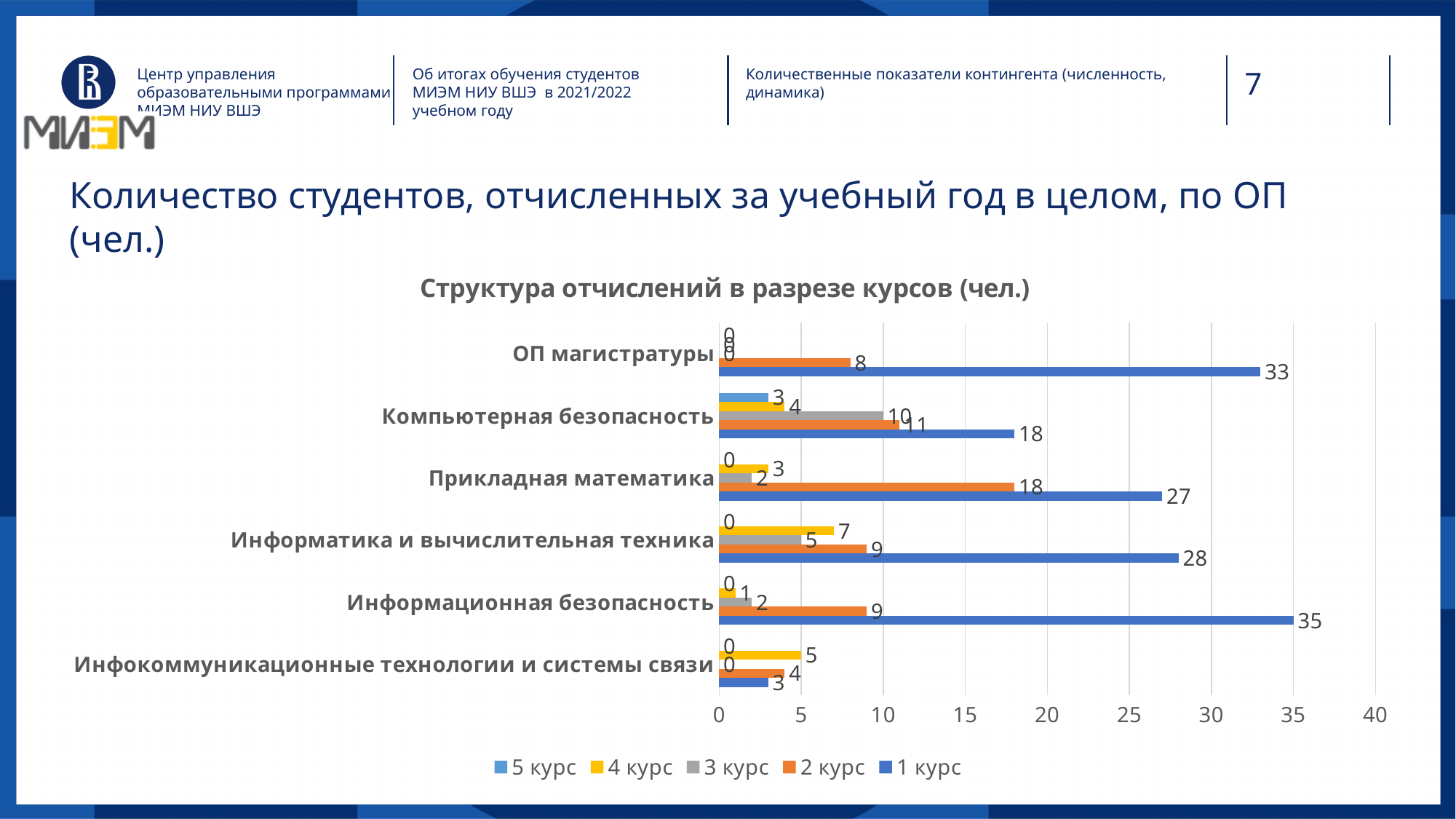
What kind of chart is shown on the slide? bar chart Is the 1 курс value for Информатика и вычислительная техника greater or less than 25? greater How many series does the legend list? 5 What is the value for 2 курс in Прикладная математика? 18 How many students of 1 курс were expelled from Информационная безопасность? 35 What is the value for 3 курс in Компьютерная безопасность? 10 Which programme has the highest value for 1 курс? Информационная безопасность What is the difference between the 1 курс values for Информационная безопасность and ОП магистратуры? 2 What is the total number of expelled students across all courses for Компьютерная безопасность? 46 Which has the larger 2 курс value: Прикладная математика or Компьютерная безопасность? Прикладная математика How many programmes (categories) are shown on the chart? 6 Which programme has the lowest value for 1 курс? Инфокоммуникационные технологии и системы связи